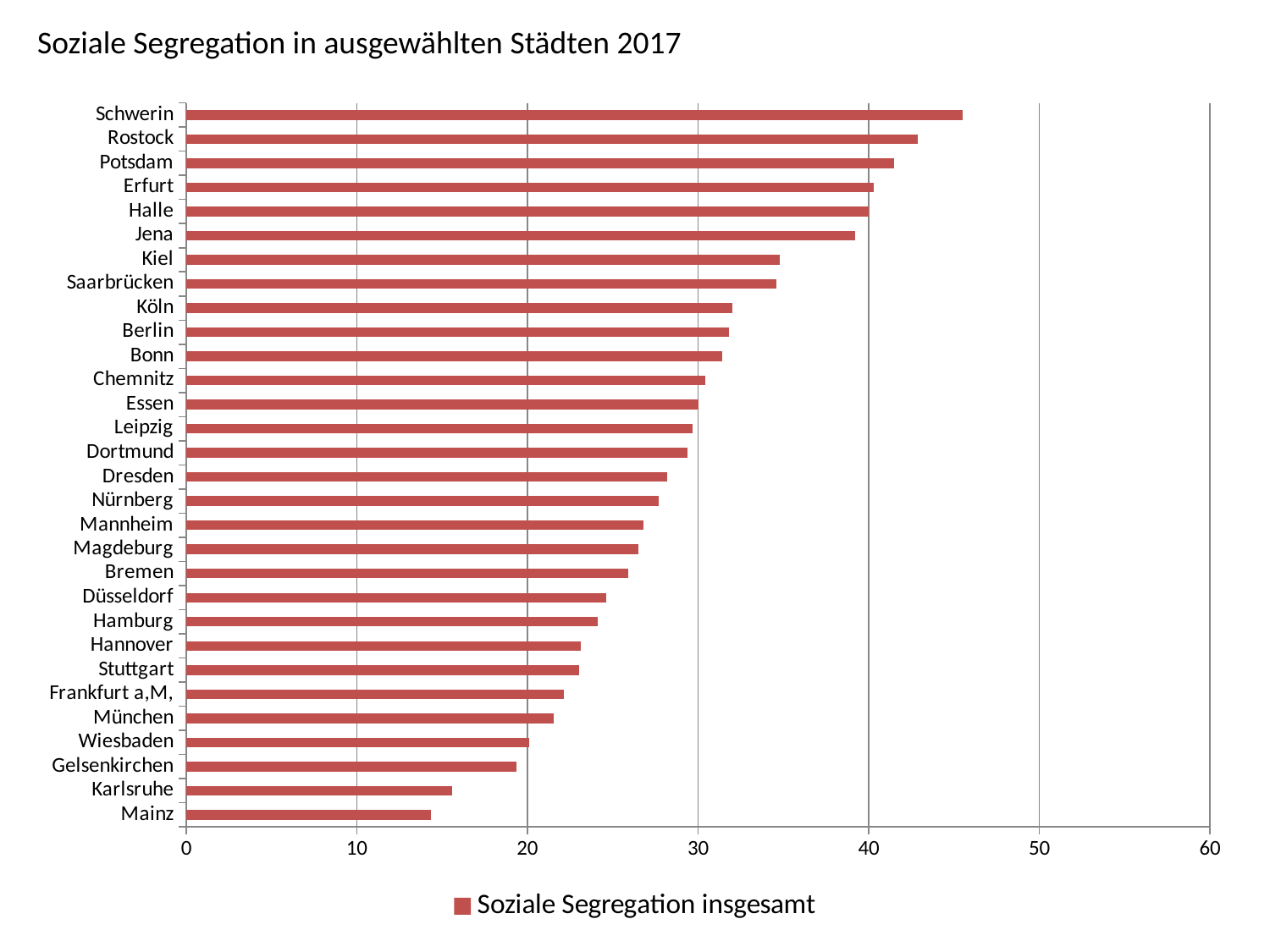
What kind of chart is shown on the slide? bar chart Which city has the highest value for Soziale Segregation insgesamt? Schwerin Is the value for Bremen greater or less than 30? less Is the value for Kiel greater or less than 30? greater How many series does the legend list? 1 Which city has the lowest value for Soziale Segregation insgesamt? Mainz What is the title of the chart? Soziale Segregation in ausgewählten Städten 2017 Which has the larger value, Potsdam or Köln? Potsdam Which has the larger value, Hamburg or Karlsruhe? Hamburg How many cities are shown in the chart? 30 Is the value for Schwerin greater or less than 40? greater